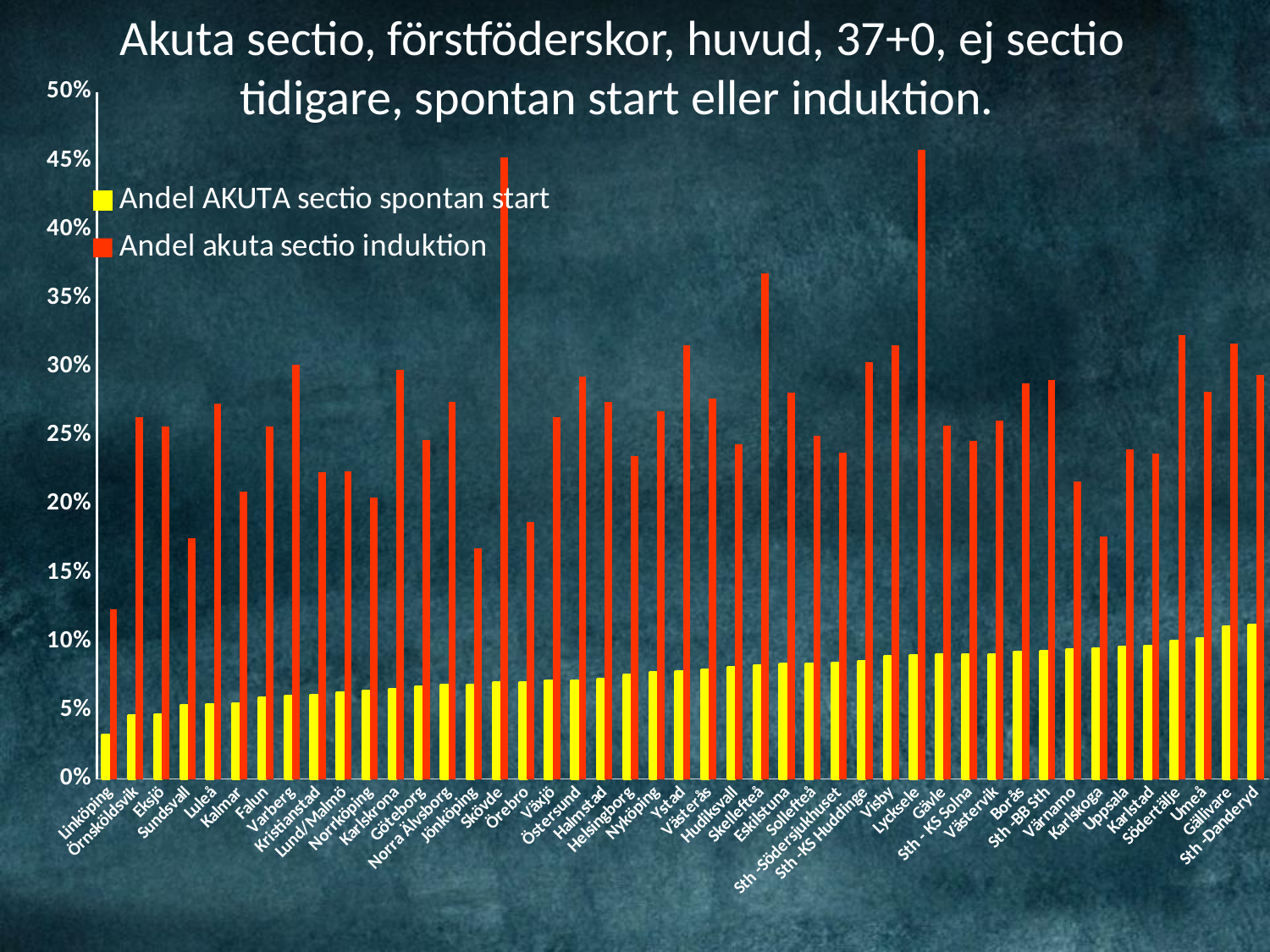
How many hospitals (categories) are shown on the x axis? 45 Which hospital has the lowest value for 'Andel AKUTA sectio spontan start'? Linköping Do the values for 'Andel AKUTA sectio spontan start' rise or fall from left to right along the x axis? rise Which hospital has the lowest value for 'Andel akuta sectio induktion'? Linköping Is the 'Andel akuta sectio induktion' value for Linköping greater or less than 15%? less Is the 'Andel akuta sectio induktion' value for Skövde greater or less than 40%? greater Which series is shown in yellow? Andel AKUTA sectio spontan start Which has the larger 'Andel akuta sectio induktion' value, Varberg or Kristianstad? Varberg Is the 'Andel AKUTA sectio spontan start' value for Sth -Danderyd greater or less than 10%? greater What kind of chart is shown on the slide? bar chart Which has the larger 'Andel akuta sectio induktion' value, Lycksele or Örebro? Lycksele How many series does the legend list? 2